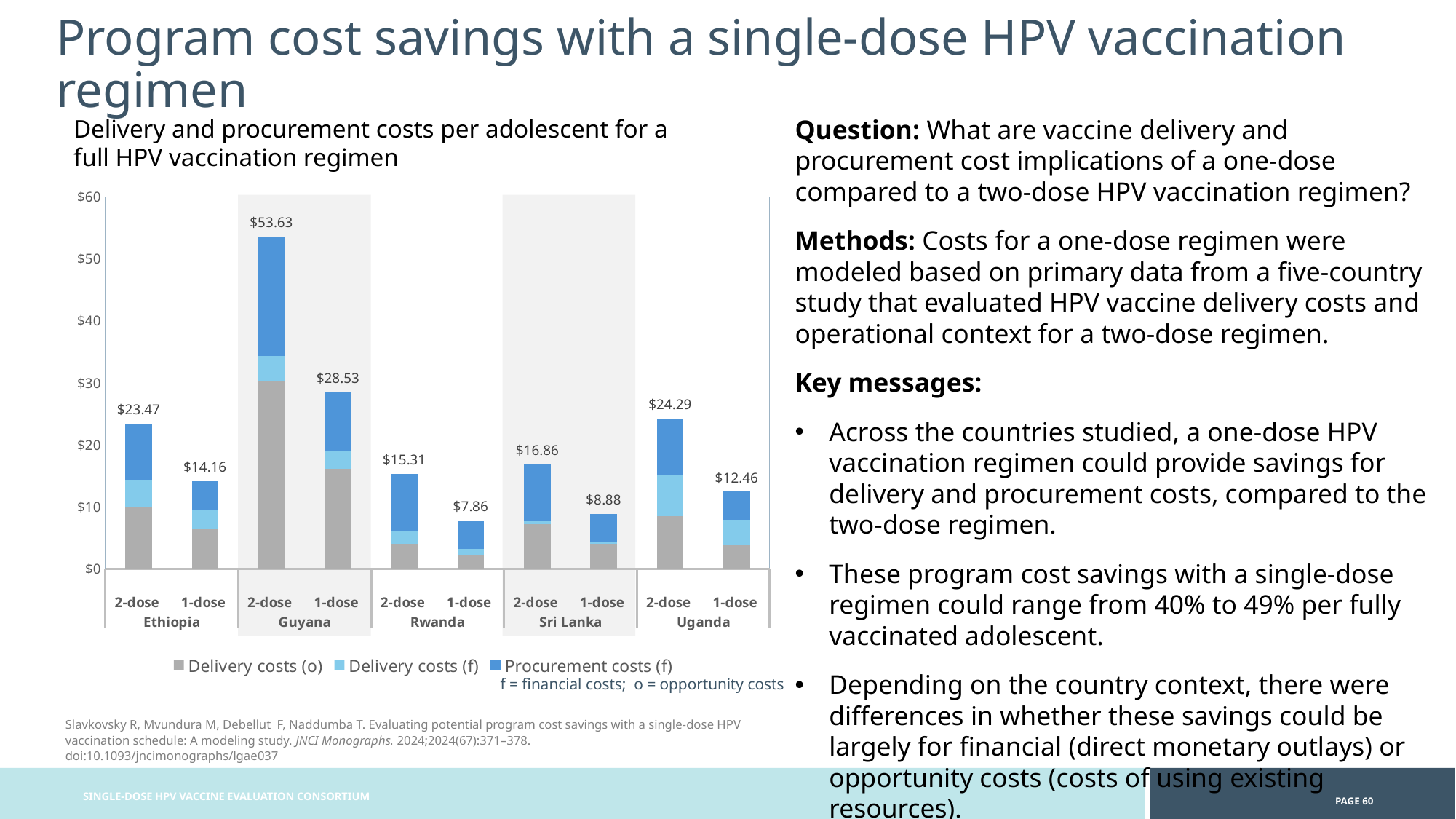
How many bars are plotted in the chart? 10 Which bar has the lowest total cost per adolescent? Rwanda 1-dose ($7.86) What is the total cost per adolescent for the 1-dose regimen in Rwanda? $7.86 Is the Delivery costs (o) value for the Guyana 1-dose bar greater or less than $10? greater How many series does the legend list? 3 What is the total delivery and procurement cost per adolescent for the 2-dose regimen in Guyana? $53.63 What is the total cost per adolescent for the 1-dose regimen in Uganda? $12.46 Which bar has the highest total cost per adolescent? Guyana 2-dose ($53.63) Which has a higher total cost: the 2-dose regimen in Uganda or the 2-dose regimen in Ethiopia? Uganda 2-dose ($24.29) What kind of chart is shown on the slide? Stacked bar chart What is the difference in total cost between the 2-dose and 1-dose regimens in Ethiopia? $9.31 What is the difference in total cost between the 2-dose and 1-dose regimens in Guyana? $25.10